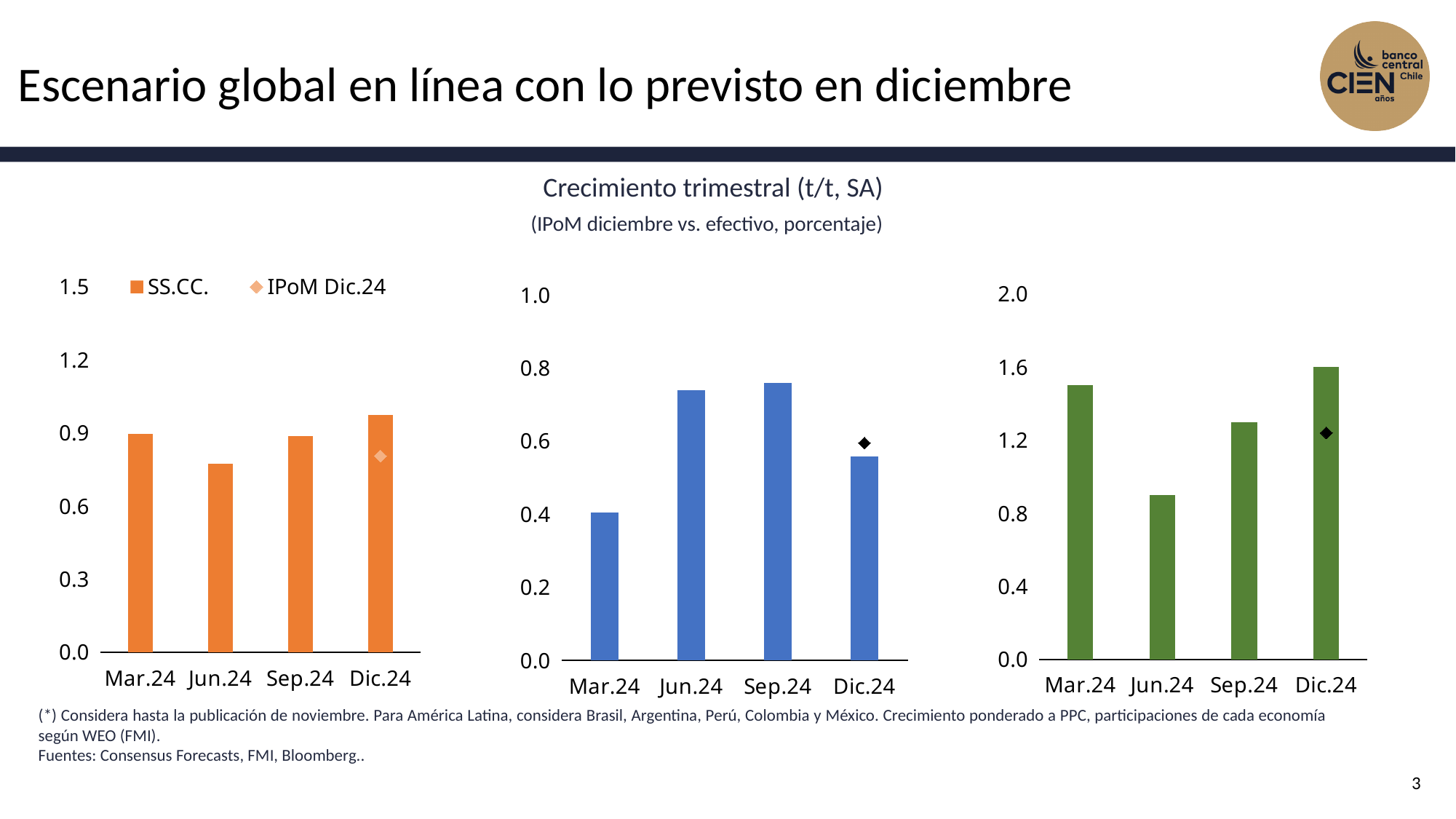
On the middle (blue) chart, is the value for Dic.24 greater or less than 0.6? less On the right (green) chart, which quarter has the highest bar? Dic.24 On the left (orange) chart, which quarter has the highest bar? Dic.24 How many series does the legend on the left (orange) chart list? 2 On the right (green) chart, which quarter has the lowest bar? Jun.24 On the left (orange) chart, which quarter has the lowest bar? Jun.24 On the middle (blue) chart, which quarter has the lowest bar? Mar.24 How many quarters are shown on the x axis of the middle (blue) chart? 4 On the middle (blue) chart, is the value for Jun.24 greater or less than 0.6? greater On the left (orange) chart, is the value for Jun.24 greater or less than 0.9? less On the right (green) chart, which is larger, the bar for Mar.24 or the bar for Sep.24? Mar.24